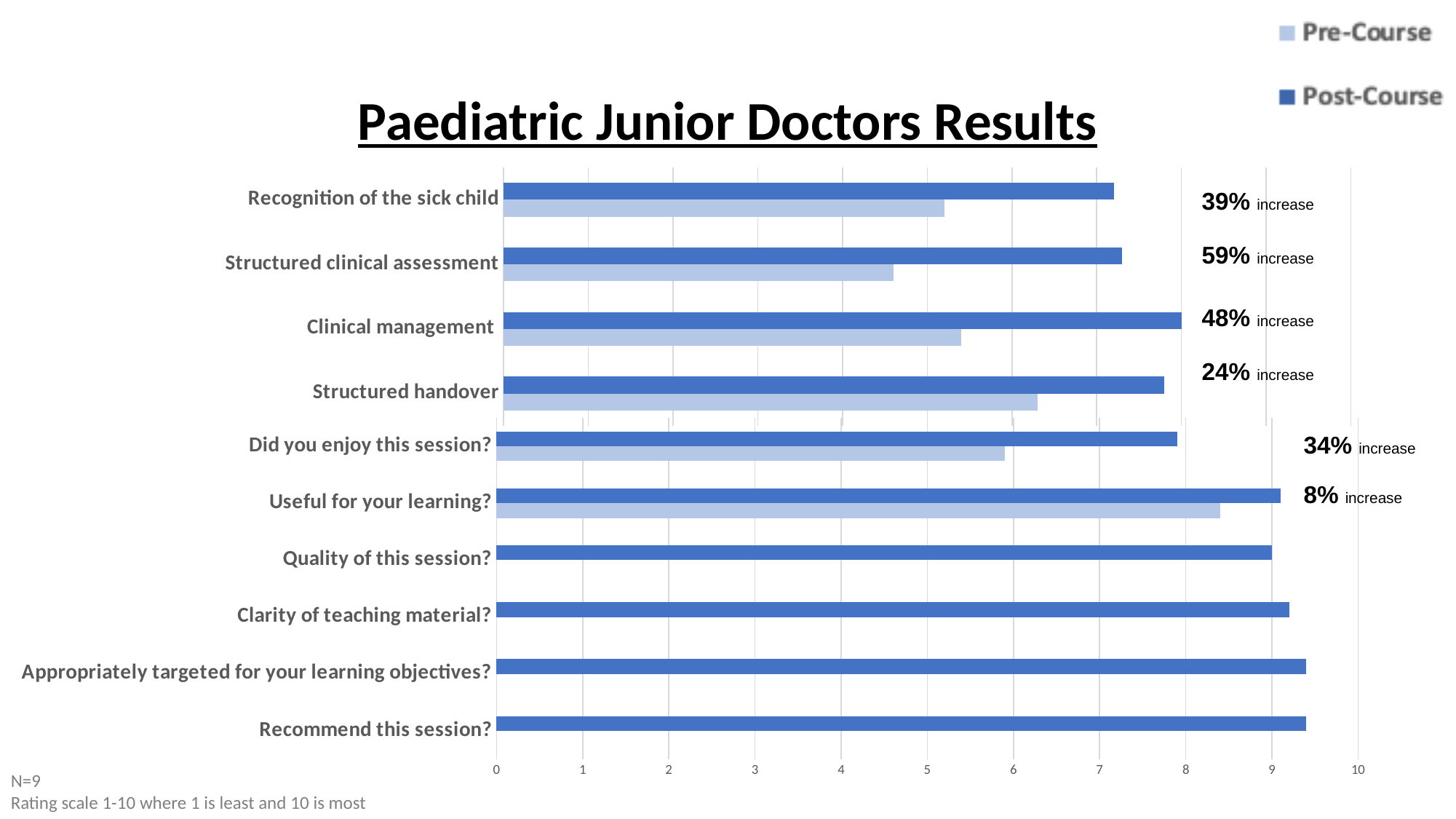
In the upper chart, which category has the highest Post-Course value? Clinical management In the lower chart, which category has the lowest Post-Course value? Did you enjoy this session? In the upper chart (Recognition of the sick child to Structured handover), how many categories are shown? 4 In the upper chart, which category has the highest Pre-Course value? Structured handover What percentage increase is shown next to Structured handover? 24% increase How many series does the legend list? 2 In the upper chart, is the Pre-Course value for Structured clinical assessment greater or less than 5? less What kind of chart is used on the slide? bar chart In the upper chart, is the Post-Course value for Recognition of the sick child greater or less than 7? greater In the upper chart, which category has the lowest Pre-Course value? Structured clinical assessment In the lower chart, is the Pre-Course value for Useful for your learning? greater or less than 8? greater In the lower chart (Did you enjoy this session? to Recommend this session?), how many categories are shown? 6